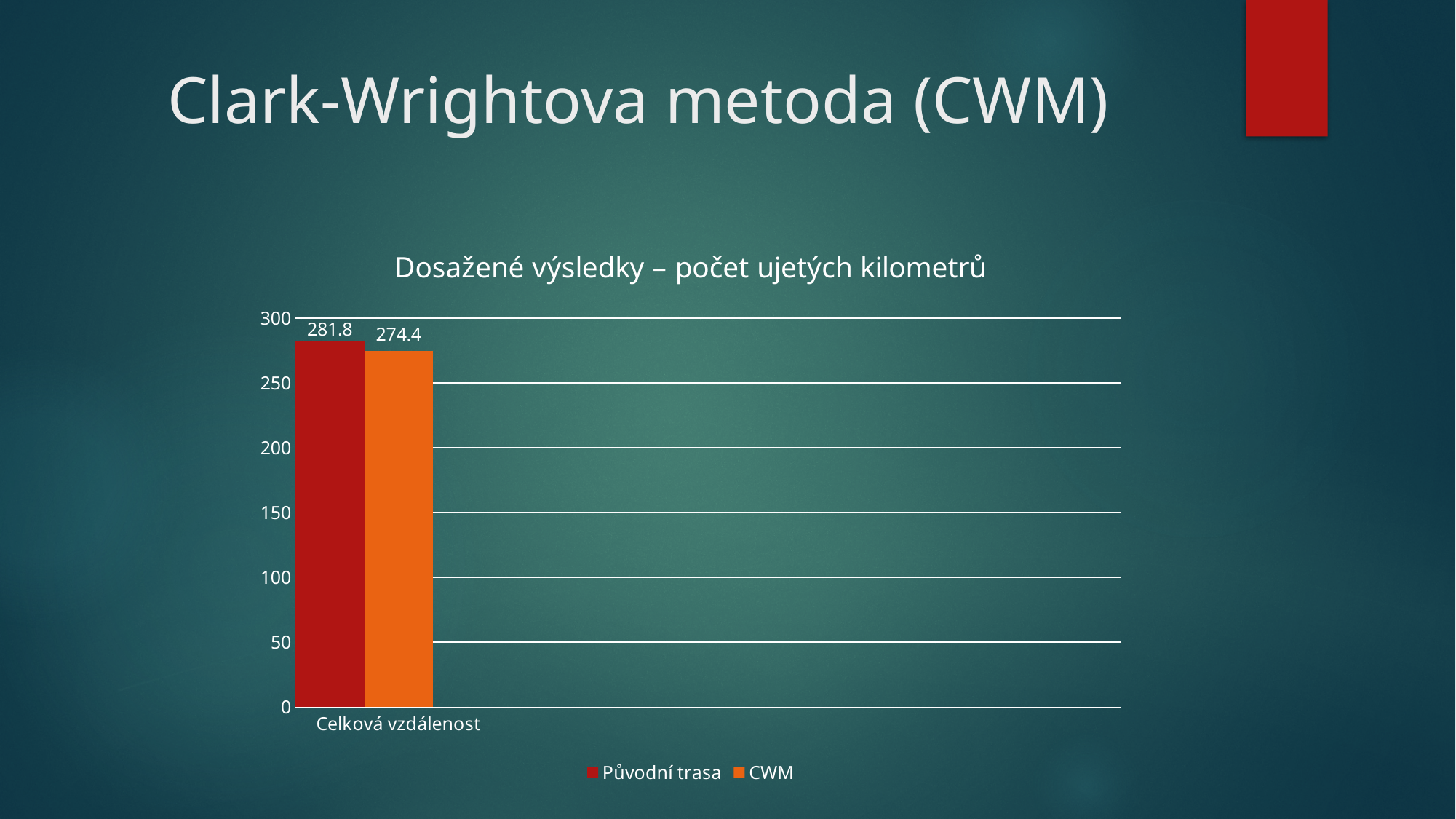
What is the value for CWM? 274.4 What is the value for Původní trasa? 281.8 Which series has the higher value, Původní trasa or CWM? Původní trasa How many series does the legend list? 2 Which series has the lowest value? CWM What is the difference between the Původní trasa value and the CWM value? 7.4 What is the label of the category on the x axis? Celková vzdálenost What is the title of the chart? Dosažené výsledky – počet ujetých kilometrů Is the value for Původní trasa greater or less than 300? less What kind of chart is shown on the slide? bar chart How many categories are shown on the x axis? 1 Is the value for CWM greater or less than 250? greater